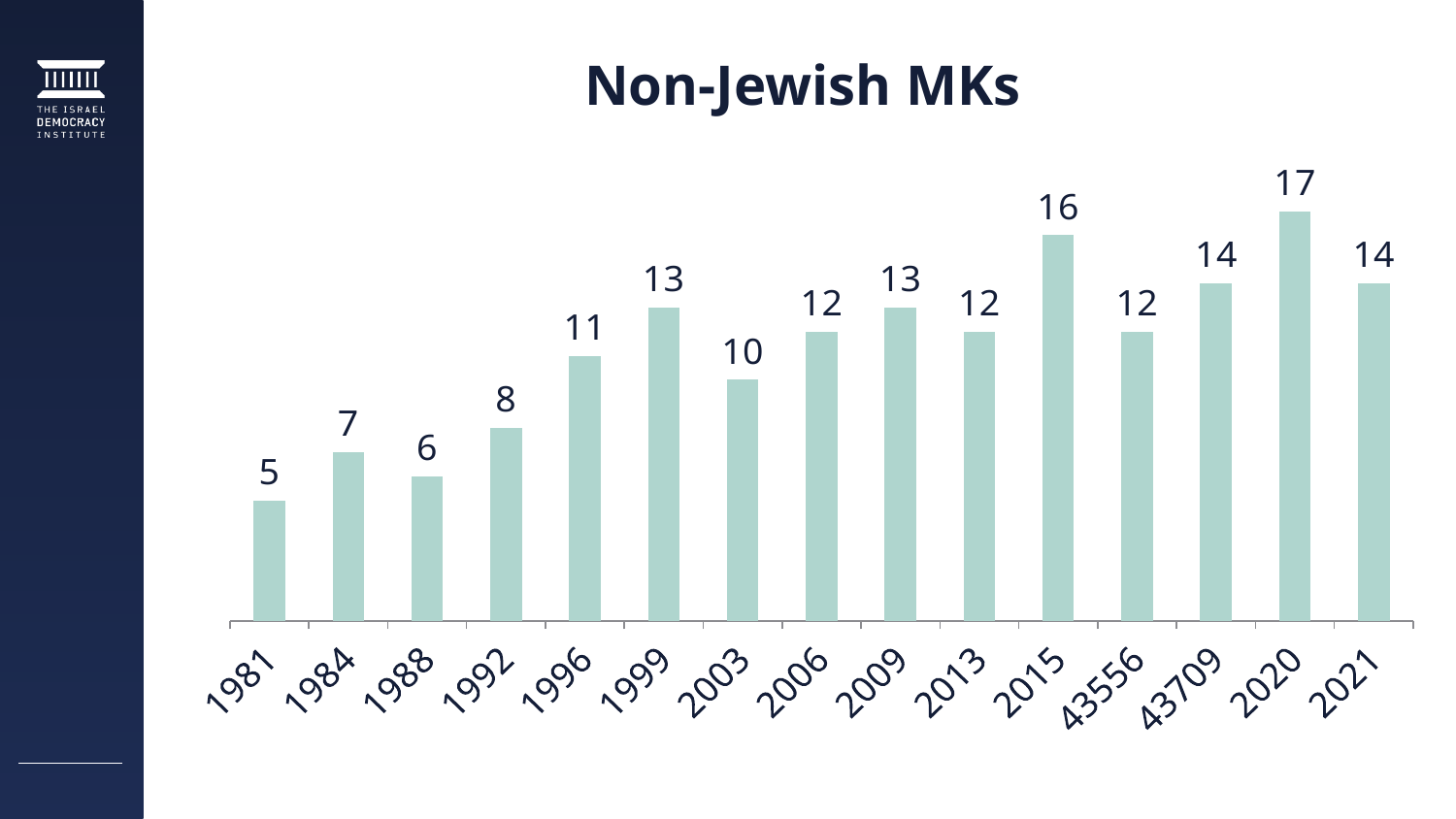
Which is larger, the value for 1984 or the value for 1988? 1984 Which is larger, the value for 2015 or the value for 2013? 2015 What is the value for 1981 in the Non-Jewish MKs chart? 5 What is the difference between the values for 1996 and 1981? 6 What is the difference between the values for 2020 and 2021? 3 Which year has the highest number of non-Jewish MKs? 2020 How many bars are shown in the chart? 15 What is the title of the chart? Non-Jewish MKs How many non-Jewish MKs are shown for 2015? 16 Which year has the lowest number of non-Jewish MKs? 1981 What is the value for 2003 in the chart? 10 What kind of chart is shown on the slide? Bar chart